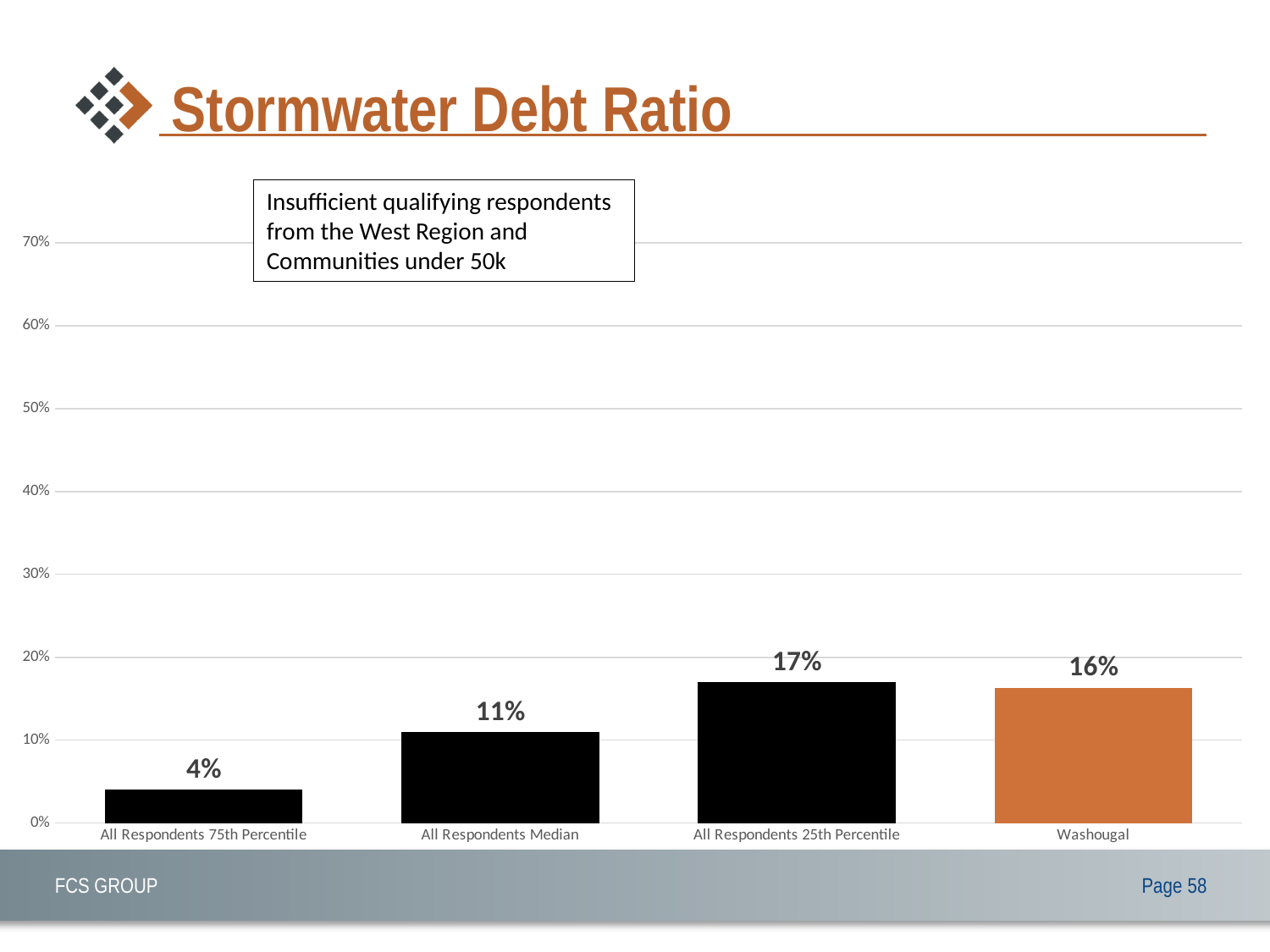
Which category has the lowest value? All Respondents 75th Percentile What is the difference between the values for Washougal and All Respondents Median? 5% What is the difference between the values for All Respondents 25th Percentile and Washougal? 1% What is the value for All Respondents 25th Percentile? 17% What kind of chart is shown on the slide? bar chart What is the value for All Respondents Median? 11% What is the value for All Respondents 75th Percentile? 4% What is the value for Washougal? 16% Which category has the highest value? All Respondents 25th Percentile How many categories are shown on the chart? 4 Is the value for All Respondents 25th Percentile greater or less than 20%? less Which is larger, the value for Washougal or the value for All Respondents Median? Washougal